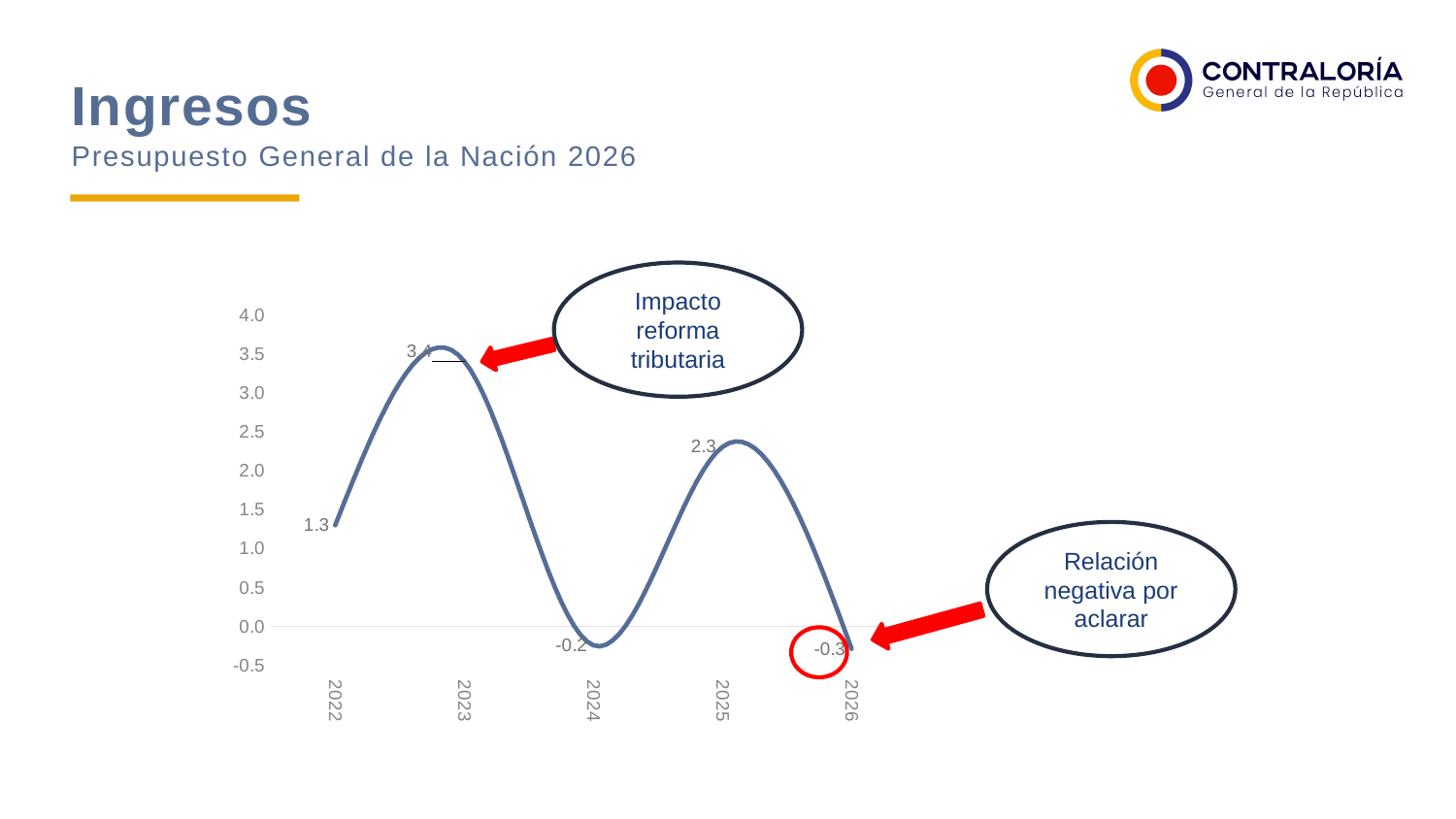
Which is larger, the value for 2022 or the value for 2025? 2025 How many years are plotted on the x axis? 5 What is the value for 2024? -0.2 What is the value for 2022? 1.3 Is the value for 2025 greater or less than 2.0? greater What kind of chart is shown on the slide? line chart Does the value rise or fall from 2025 to 2026? fall Which year has the highest value? 2023 What is the difference between the values for 2023 and 2025? 1.1 Which year has the lowest value? 2026 What is the value for 2023? 3.4 What is the value for 2026? -0.3